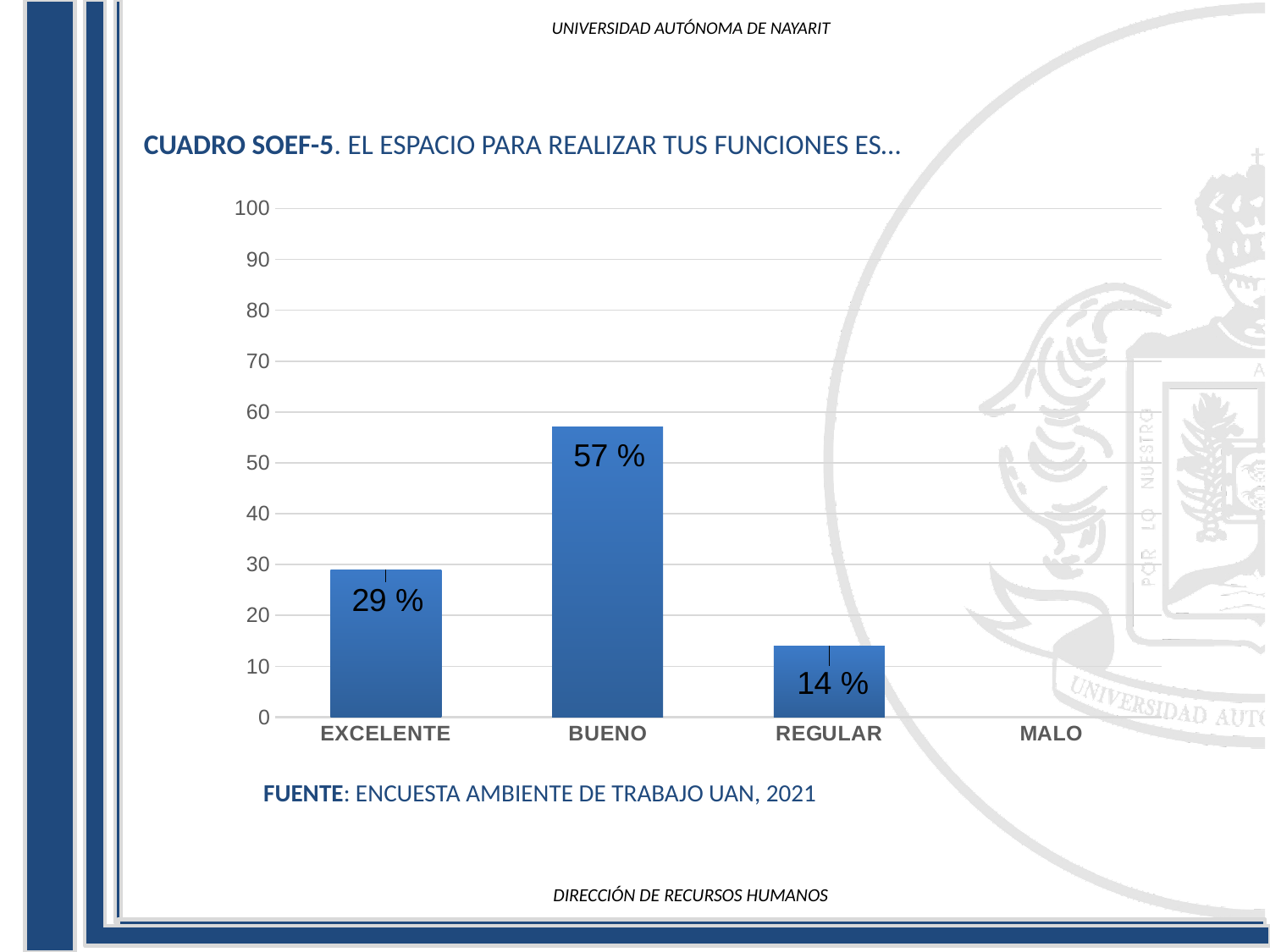
What kind of chart is shown on the slide? bar chart What is the source cited below the chart? ENCUESTA AMBIENTE DE TRABAJO UAN, 2021 Is the value for BUENO greater or less than 50? greater How many categories are shown on the x axis? 4 What is the value for BUENO? 57 % What is the difference between the values for EXCELENTE and REGULAR? 15 % Which category has the highest value? BUENO What is the difference between the values for BUENO and EXCELENTE? 28 % What is the value for EXCELENTE? 29 % What is the value for REGULAR? 14 % Which category with a visible bar has the lowest value? REGULAR Which is larger, the value for EXCELENTE or the value for REGULAR? EXCELENTE